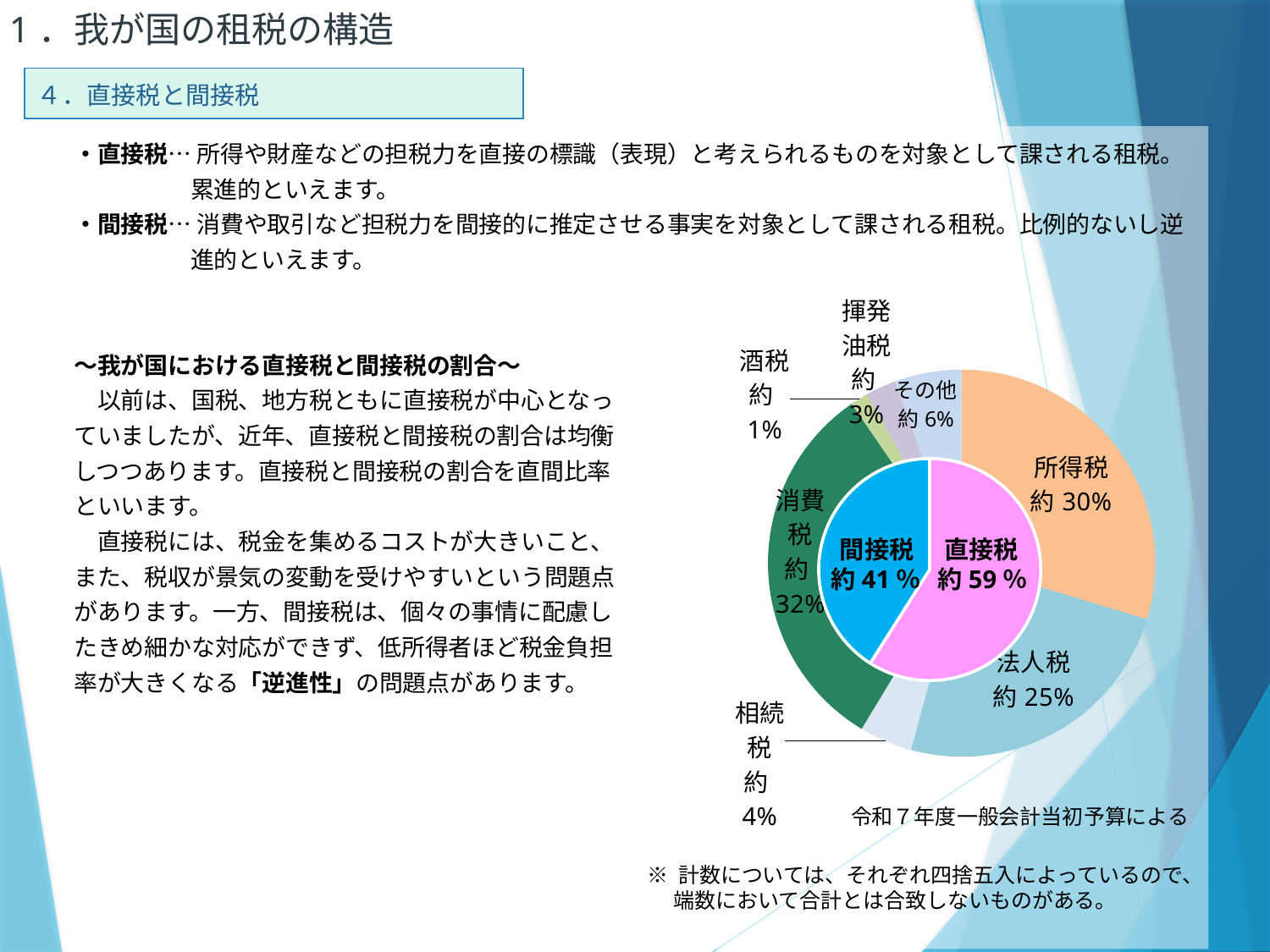
円グラフの外側の輪で、最も割合が大きい税目はどれですか？ 消費税 円グラフの内側の輪で、間接税の割合はいくらですか？ 約 41% 円グラフで、消費税の割合はいくらですか？ 約 32% 円グラフで、所得税と法人税ではどちらの割合が大きいですか？ 所得税 このグラフはどの種類のグラフですか？ 円グラフ 円グラフで、所得税の割合はいくらですか？ 約 30% 円グラフで、相続税の割合はいくらですか？ 約 4% 円グラフで、所得税と法人税の割合の差は何ポイントですか？ 5ポイント 円グラフの内側の輪で、直接税の割合はいくらですか？ 約 59% 円グラフで、法人税の割合はいくらですか？ 約 25% 円グラフの外側の輪には、いくつの税目が示されていますか？ 7 円グラフの外側の輪で、最も割合が小さい税目はどれですか？ 酒税